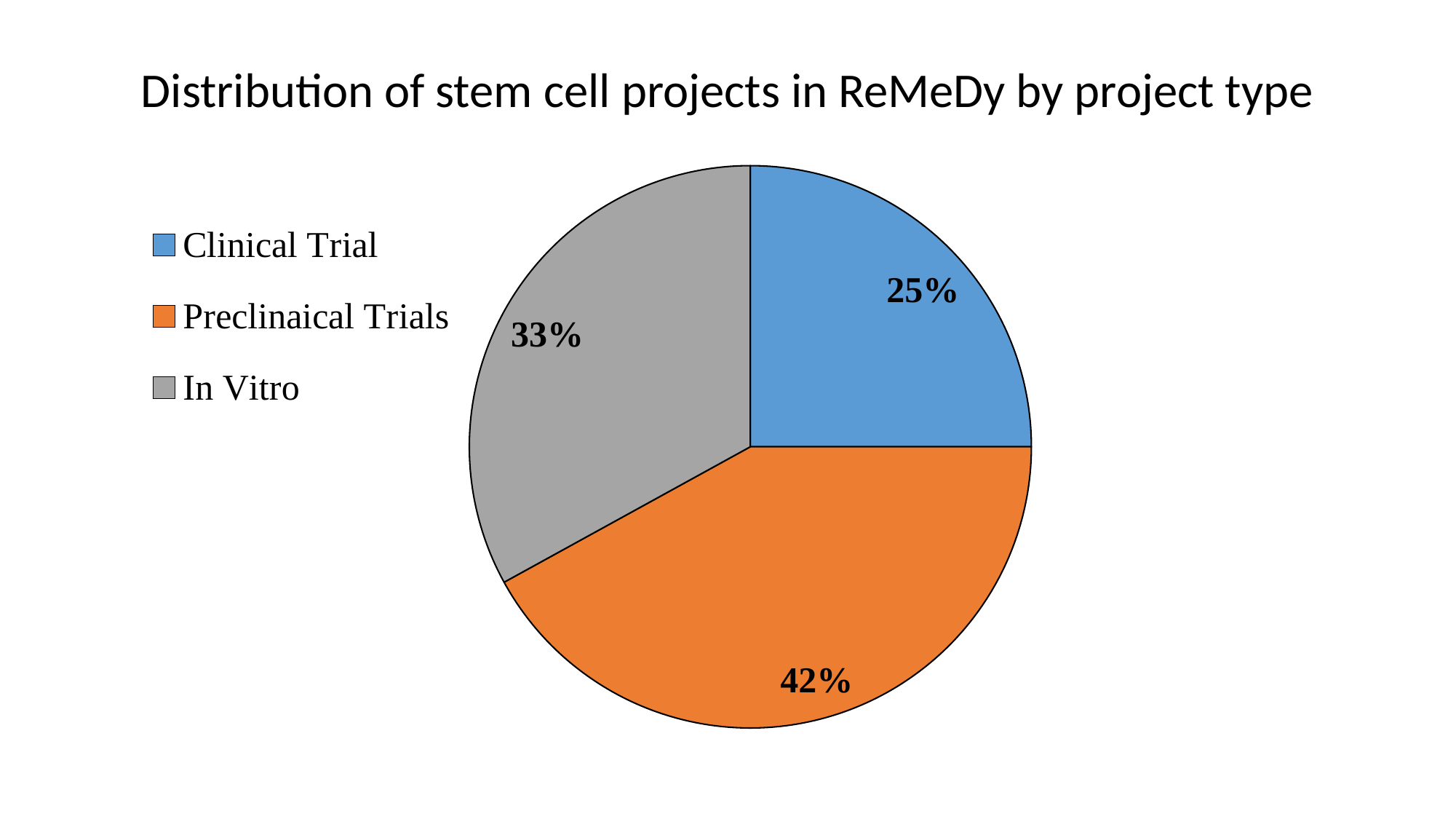
What is the difference in percentage points between In Vitro and Clinical Trial? 8% What share of the pie is In Vitro? 33% Which is larger, the share for In Vitro or the share for Clinical Trial? In Vitro Which project type has the largest share of the pie? Preclinaical Trials What colour is the In Vitro slice? grey What kind of chart is shown on the slide? pie chart What share of the pie is Preclinaical Trials? 42% What is the difference in percentage points between Preclinaical Trials and Clinical Trial? 17% What share of the pie is Clinical Trial? 25% How many slices does the pie chart have? 3 Which project type has the smallest share of the pie? Clinical Trial What is the title of the chart? Distribution of stem cell projects in ReMeDy by project type